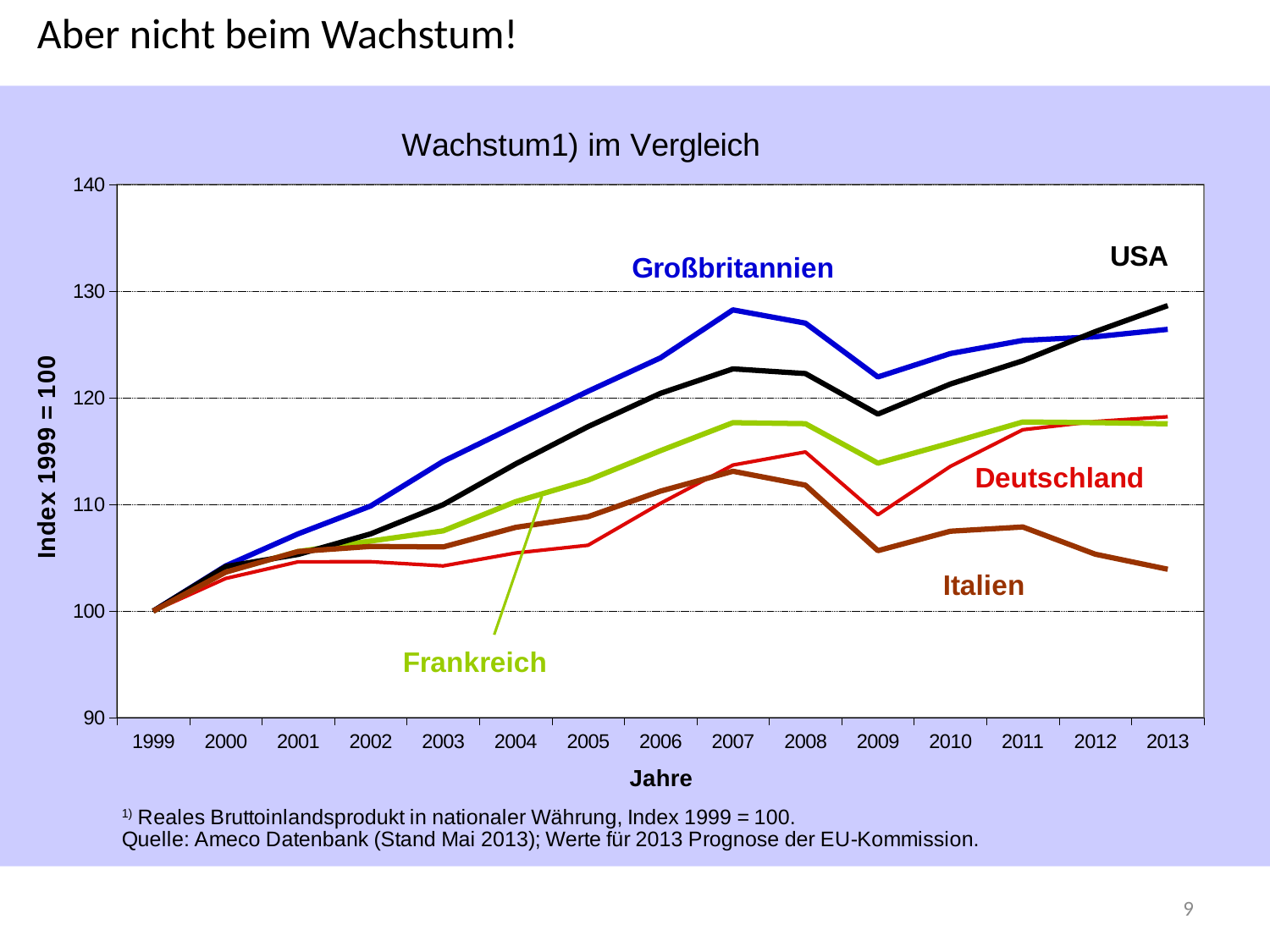
Is the value for Frankreich in 2013 greater or less than 110? greater How many years are shown on the x axis of the chart? 15 Is the value for Großbritannien in 2007 greater or less than 120? greater Which country has the highest index value in 2013? USA Which country has the lowest index value in 2013? Italien Which country has the highest index value in 2007? Großbritannien In 2009, which is higher: the value for Deutschland or the value for Italien? Deutschland What kind of chart is shown on the slide? line chart Does the line for Italien rise or fall from 2011 to 2013? fall What is the index value for all countries in 1999? 100 How many countries are plotted in the chart "Wachstum1) im Vergleich"? 5 Is the value for Italien in 2013 greater or less than 110? less